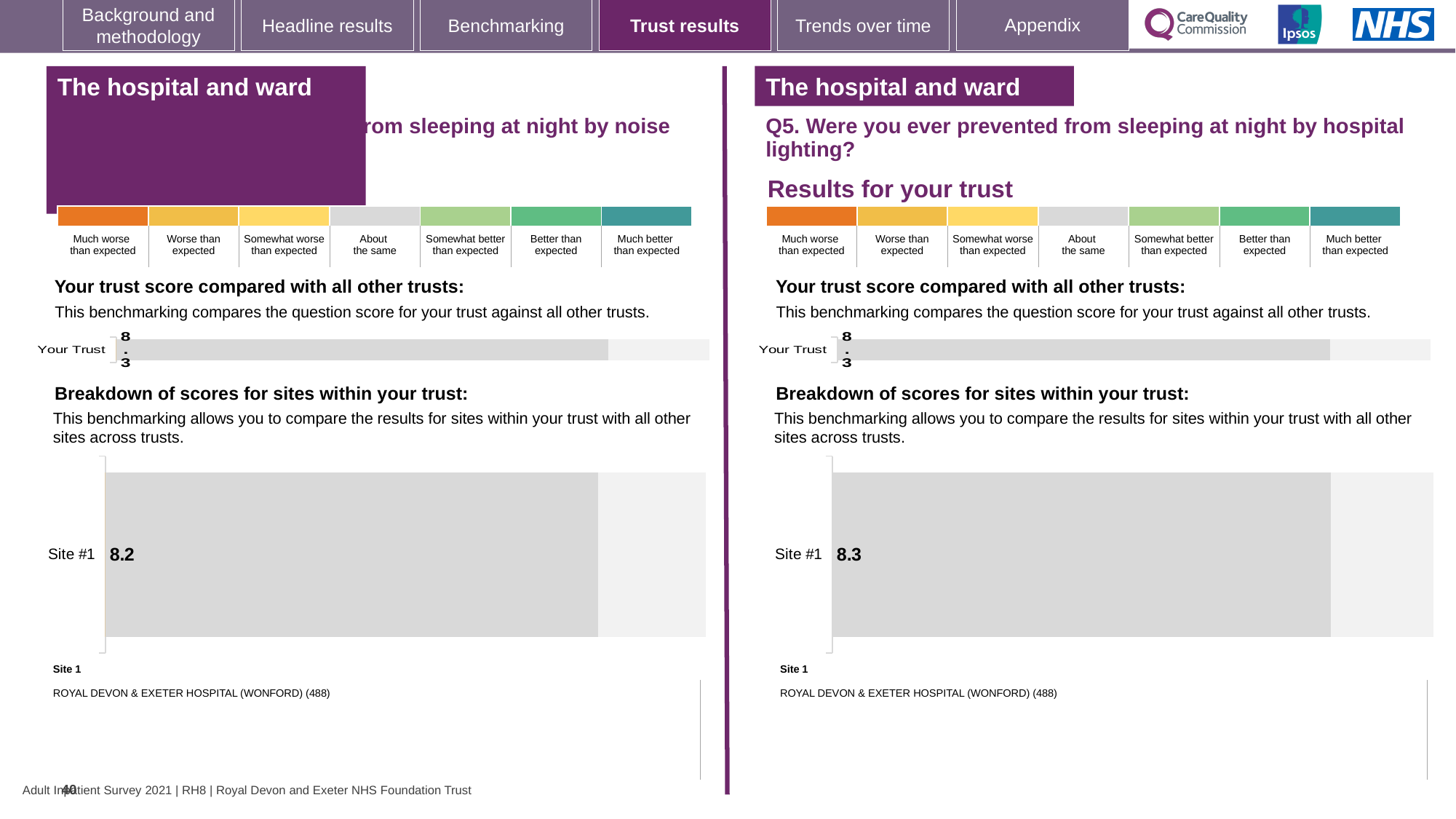
On the right-hand (Q5, hospital lighting) 'Your trust score compared with all other trusts' chart, what is the score for Your Trust? 8.3 On the right-hand (Q5, hospital lighting) site breakdown chart, what is the score for Site #1? 8.3 How many sites are shown in the left-hand site breakdown chart? 1 On the left-hand site breakdown chart, what is the score for Site #1? 8.2 Which hospital is listed as Site 1 below the right-hand (Q5, hospital lighting) site breakdown chart? ROYAL DEVON & EXETER HOSPITAL (WONFORD) What kind of chart is used for the site breakdown on the right-hand (Q5, hospital lighting) side? Bar chart What number appears in parentheses after the Site 1 hospital name below the left-hand site breakdown chart? 488 On the left-hand side, what is the difference between the Your Trust score and the Site #1 score? 0.1 What is the difference between the Site #1 score on the right-hand (Q5, hospital lighting) site breakdown chart and the Site #1 score on the left-hand site breakdown chart? 0.1 Which Site #1 score is larger: the one on the left-hand site breakdown chart or the one on the right-hand (Q5, hospital lighting) site breakdown chart? The right-hand (Q5, hospital lighting) chart On the left-hand 'Your trust score compared with all other trusts' chart, what is the score for Your Trust? 8.3